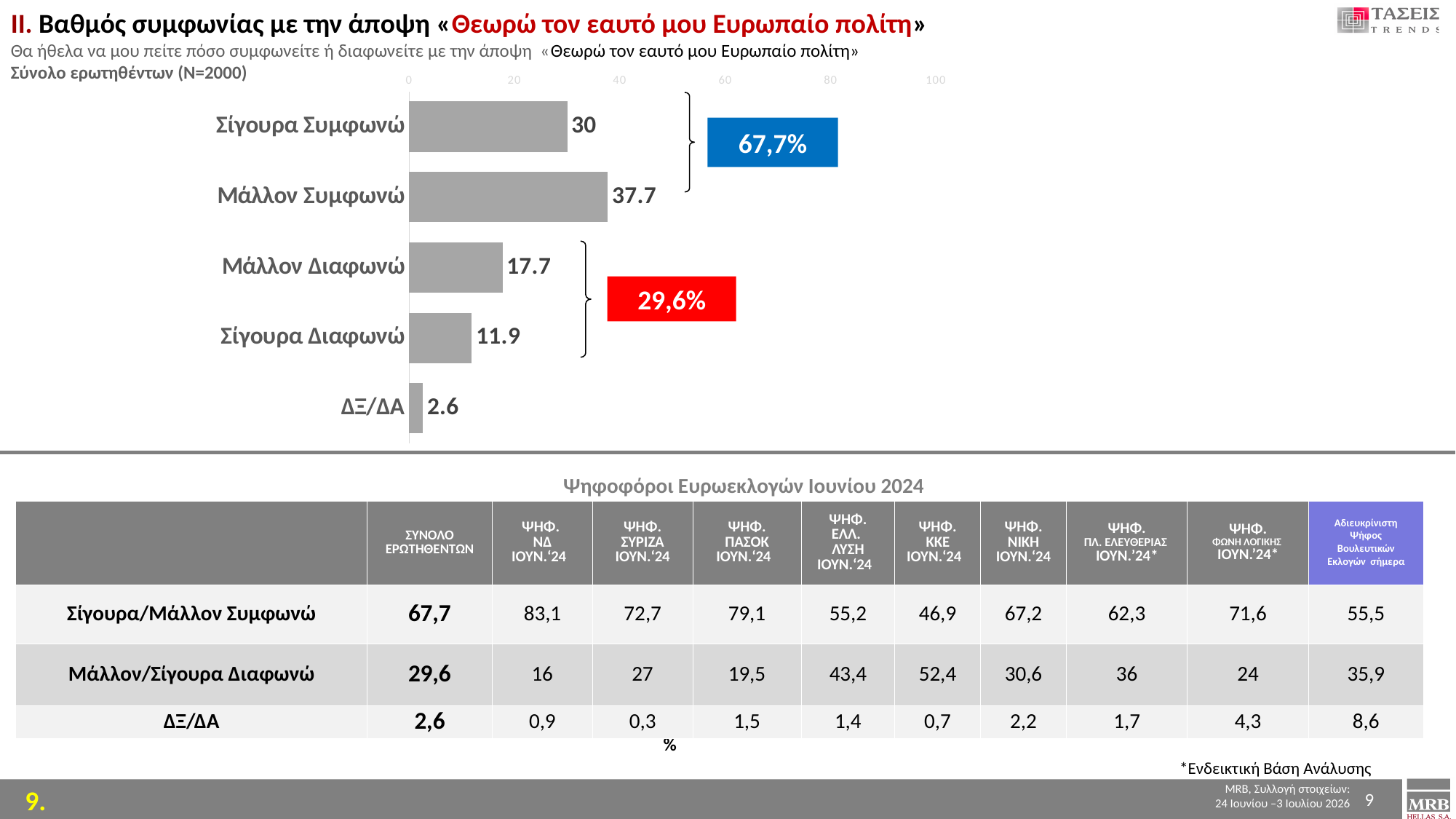
What percentage is shown in the red box next to the disagreement bars in the chart? 29,6% What kind of chart is shown on the slide? bar chart Which category has the highest value in the bar chart? Μάλλον Συμφωνώ How many categories are shown in the bar chart? 5 What value is shown for "Μάλλον Συμφωνώ" in the bar chart? 37.7 Is the value for "Σίγουρα Συμφωνώ" greater or less than 20 in the bar chart? greater Which is larger in the bar chart: the value for "Μάλλον Διαφωνώ" or for "Σίγουρα Διαφωνώ"? Μάλλον Διαφωνώ What value is shown for "ΔΞ/ΔΑ" in the bar chart? 2.6 Which category has the lowest value in the bar chart? ΔΞ/ΔΑ What value is shown for "Σίγουρα Διαφωνώ" in the bar chart? 11.9 What is the difference between the values for "Μάλλον Συμφωνώ" and "Σίγουρα Συμφωνώ" in the bar chart? 7.7 What percentage is shown in the blue box next to the agreement bars in the chart? 67,7%